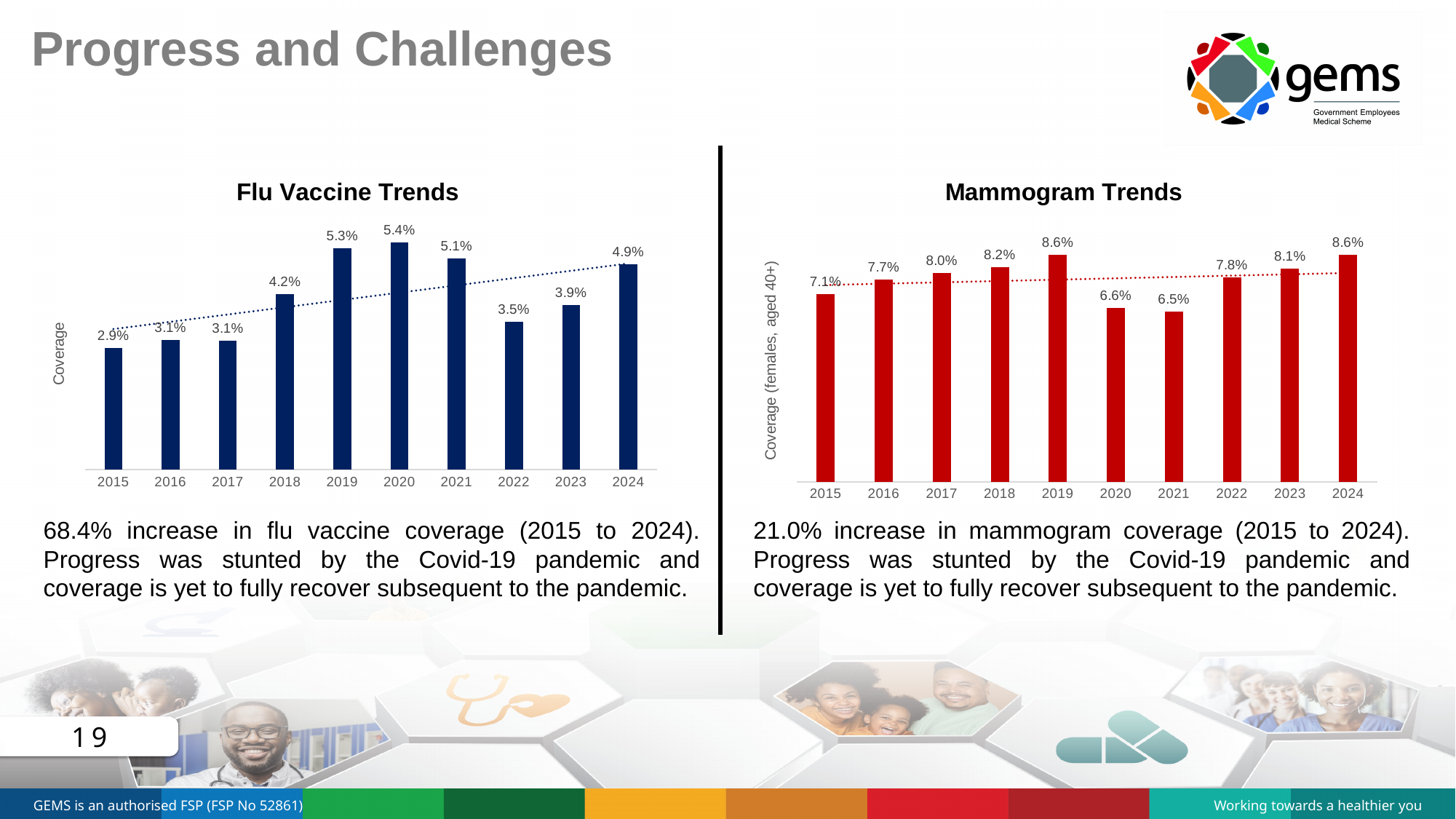
In the Flu Vaccine Trends chart, how many years are shown on the x axis? 10 In the Flu Vaccine Trends chart, what is the coverage value for 2020? 5.4% In the Flu Vaccine Trends chart, which year has the highest coverage? 2020 In the Mammogram Trends chart, what is the difference between the 2024 value and the 2015 value? 1.5% In the Flu Vaccine Trends chart, which year has the lowest coverage? 2015 In the Mammogram Trends chart, is the value for 2018 or 2022 larger? 2018 In the Flu Vaccine Trends chart, what is the difference between the 2020 value and the 2015 value? 2.5% In the Mammogram Trends chart, what is the coverage value for 2021? 6.5% In the Mammogram Trends chart, which year has the lowest coverage? 2021 In the Mammogram Trends chart, do the values rise or fall from 2015 to 2019? Rise What colour are the bars in the Mammogram Trends chart? Red What kind of chart is the Flu Vaccine Trends chart? Bar chart